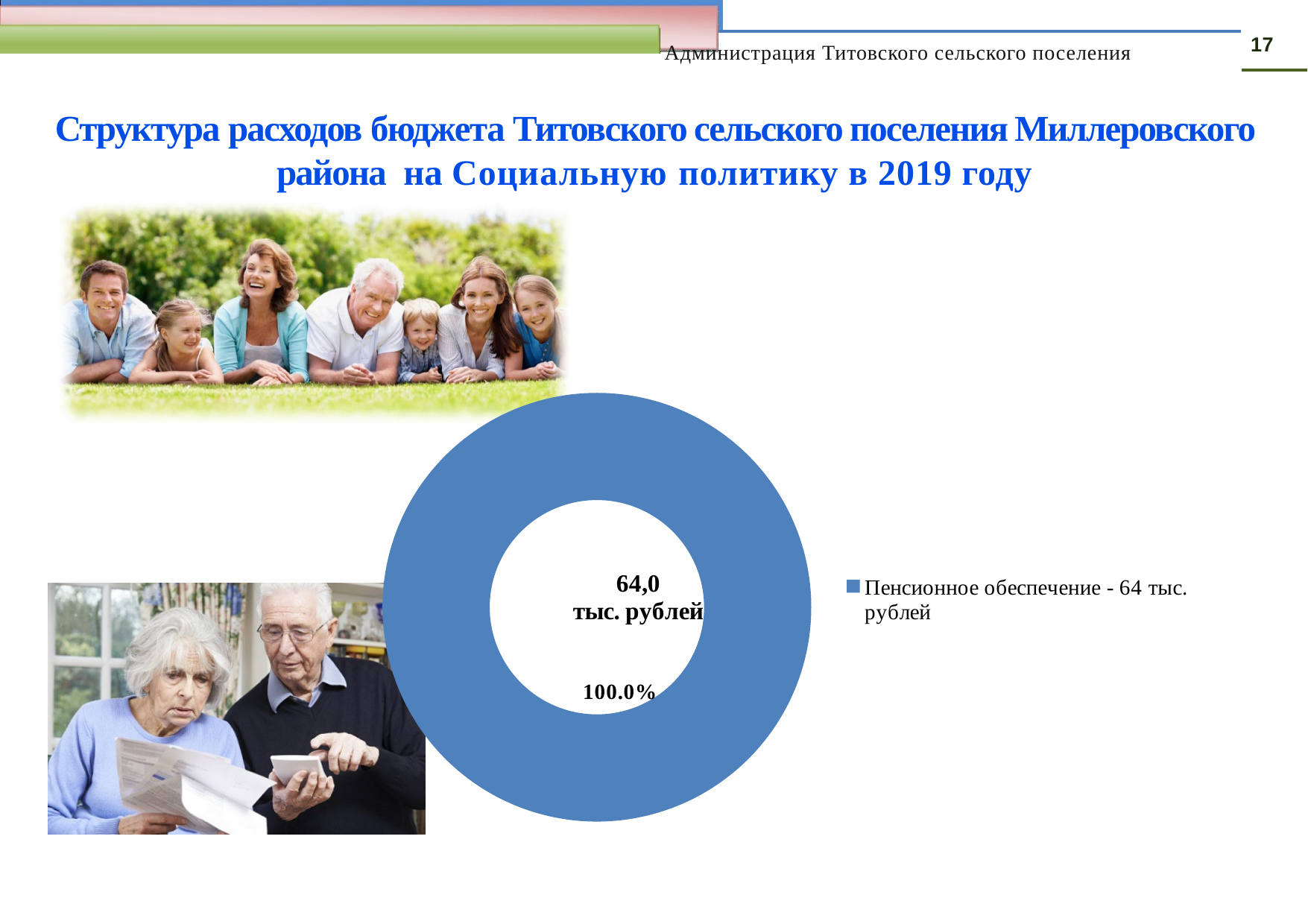
Is the value shown in the centre of the doughnut chart greater or less than 50 тыс. рублей? greater How many entries does the legend of the chart list? 1 According to the legend, what is the amount for "Пенсионное обеспечение"? 64 тыс. рублей What kind of chart is shown on the slide? Doughnut (pie) chart What share of the doughnut chart does the slice "Пенсионное обеспечение" take? 100.0% What is the name of the only category shown in the chart legend? Пенсионное обеспечение - 64 тыс. рублей What value is printed in the centre of the doughnut chart? 64,0 тыс. рублей What colour is the slice of the doughnut chart? Blue How many slices does the doughnut chart have? 1